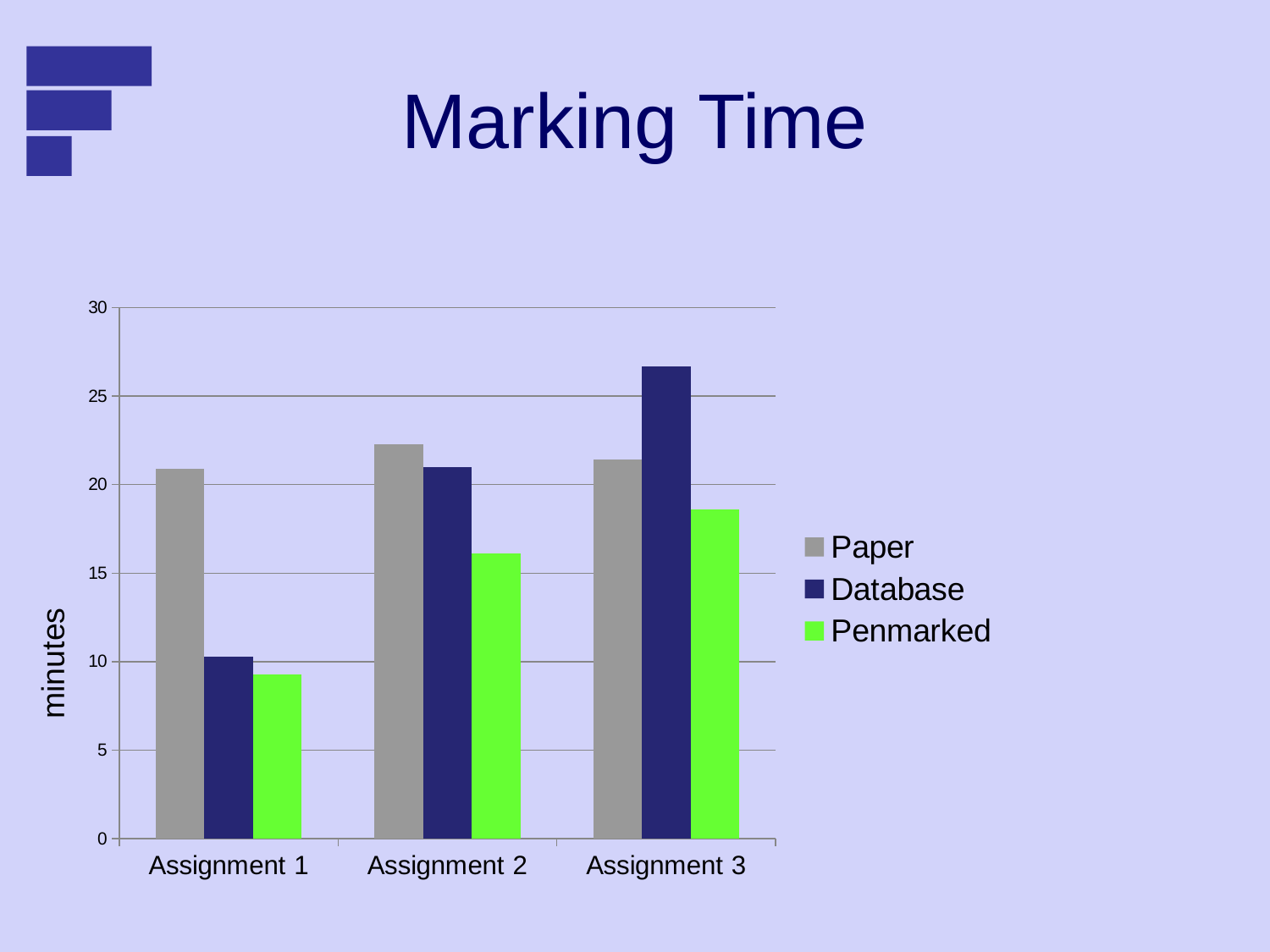
Is the Database value for Assignment 3 greater or less than 25? greater Is the Penmarked value for Assignment 1 greater or less than 10? less Is the Penmarked value for Assignment 3 greater or less than 20? less What is the label on the vertical axis? minutes How many series does the legend list? 3 How many assignment categories are shown on the x axis? 3 Which series has the highest value for Assignment 3? Database Which series has the lowest value for Assignment 1? Penmarked What kind of chart is shown on the slide? bar chart Do the Penmarked values rise or fall from Assignment 1 to Assignment 3? rise For Assignment 1, which is larger: the Paper value or the Database value? Paper